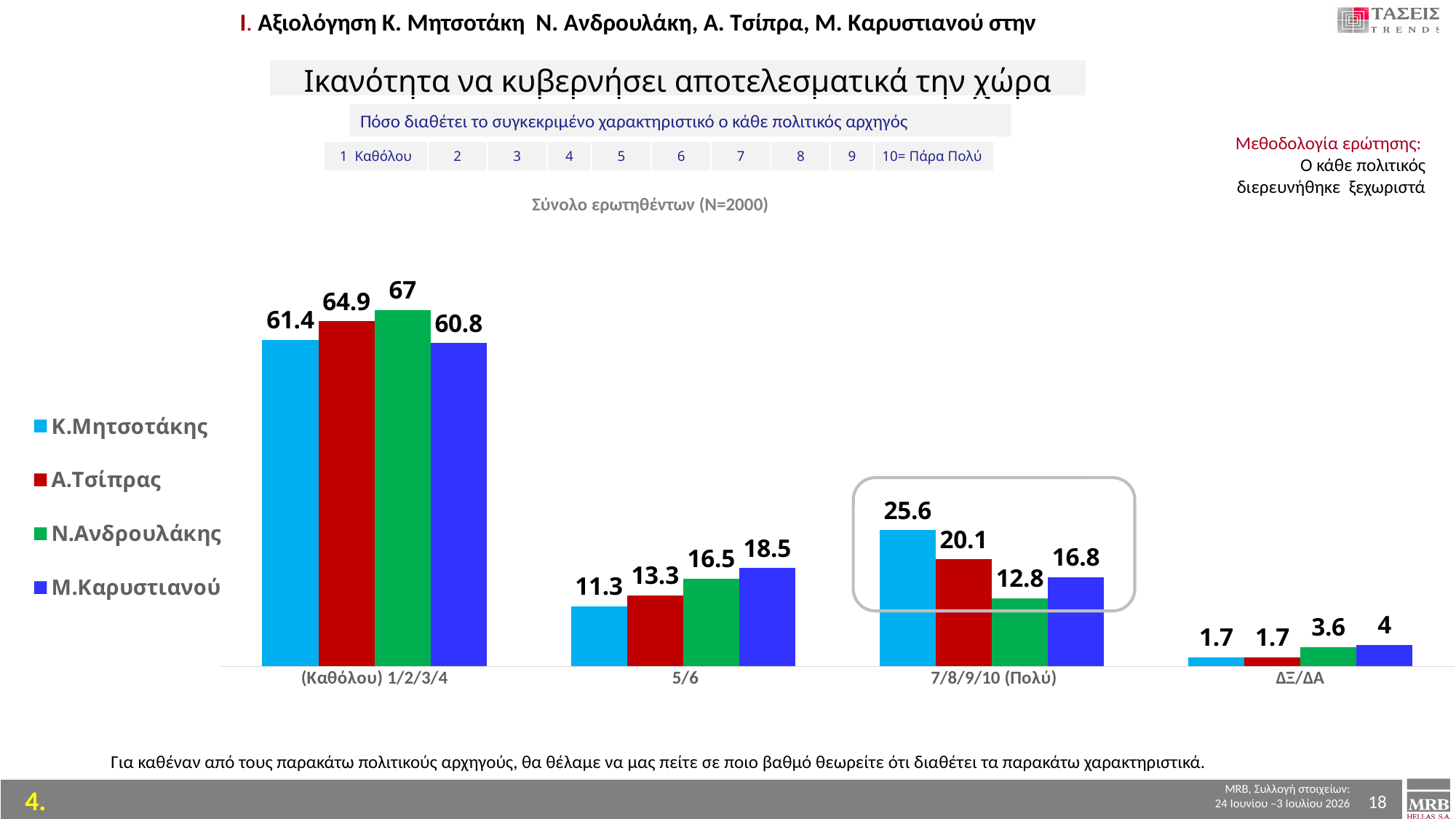
In the (Καθόλου) 1/2/3/4 category, which is larger: the value for Α.Τσίπρας or the value for Μ.Καρυστιανού? Α.Τσίπρας What is the value for Κ.Μητσοτάκης in the 7/8/9/10 (Πολύ) category? 25.6 What kind of chart is shown on the slide? Bar chart What is the value for Α.Τσίπρας in the ΔΞ/ΔΑ category? 1.7 What is the value for Ν.Ανδρουλάκης in the (Καθόλου) 1/2/3/4 category? 67 How many categories are shown on the x axis of the chart? 4 How many series does the legend list? 4 What colour represents Ν.Ανδρουλάκης in the chart? Green Which politician has the highest value in the 7/8/9/10 (Πολύ) category? Κ.Μητσοτάκης What is the value for Μ.Καρυστιανού in the 5/6 category? 18.5 Which politician has the lowest value in the 5/6 category? Κ.Μητσοτάκης What is the difference between the values for Κ.Μητσοτάκης and Ν.Ανδρουλάκης in the 7/8/9/10 (Πολύ) category? 12.8